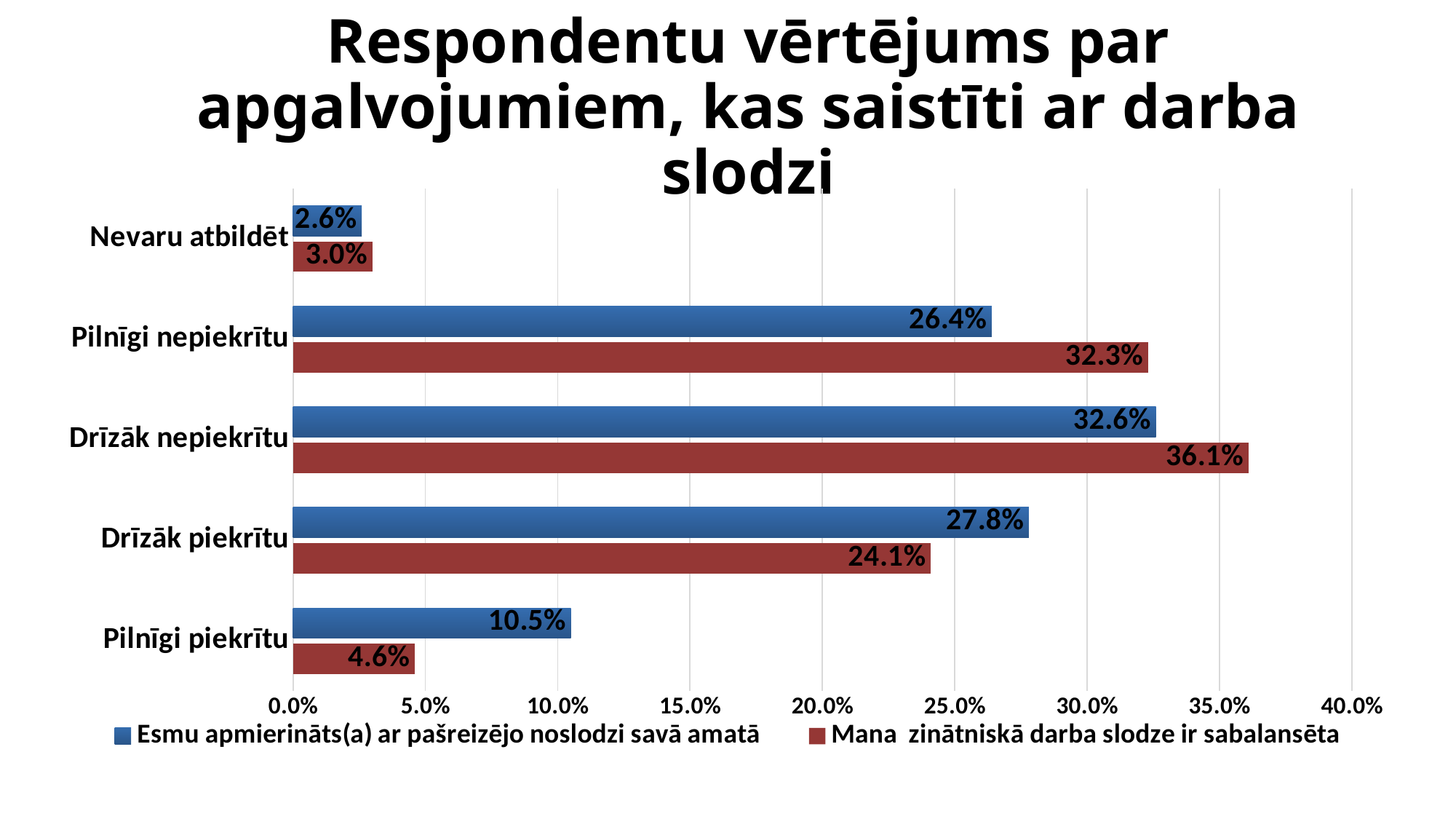
What is the difference between the two series' values for "Pilnīgi nepiekrītu"? 5.9% For "Drīzāk piekrītu", which series has the larger value? Esmu apmierināts(a) ar pašreizējo noslodzi savā amatā Is the value for "Pilnīgi nepiekrītu" in the series "Mana zinātniskā darba slodze ir sabalansēta" greater or less than 30.0%? greater Which category has the highest value in the series "Mana zinātniskā darba slodze ir sabalansēta"? Drīzāk nepiekrītu Which category has the lowest value in the series "Esmu apmierināts(a) ar pašreizējo noslodzi savā amatā"? Nevaru atbildēt What colour are the bars for the series "Mana zinātniskā darba slodze ir sabalansēta"? Red What is the value for "Nevaru atbildēt" in the series "Esmu apmierināts(a) ar pašreizējo noslodzi savā amatā"? 2.6% How many categories are shown on the chart? 5 How many series does the legend list? 2 What is the value for "Drīzāk nepiekrītu" in the series "Mana zinātniskā darba slodze ir sabalansēta"? 36.1% What is the value for "Pilnīgi piekrītu" in the series "Esmu apmierināts(a) ar pašreizējo noslodzi savā amatā"? 10.5% What kind of chart is shown on the slide? Bar chart